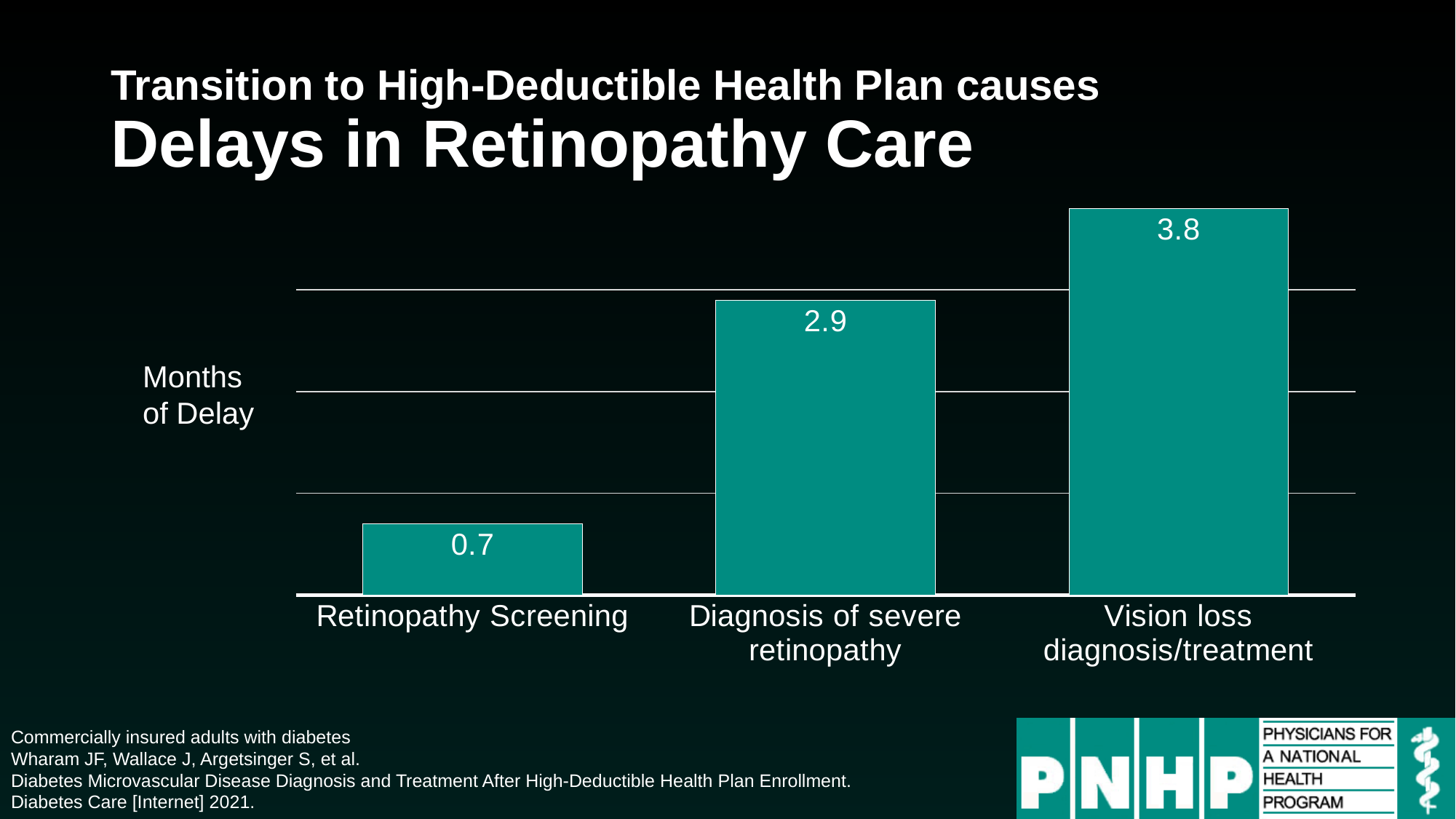
What is the months of delay for Retinopathy Screening? 0.7 What is the label on the vertical axis of the chart? Months of Delay What kind of chart is shown on the slide? Bar chart What is the months of delay for Diagnosis of severe retinopathy? 2.9 How many categories are shown in the chart? 3 Which category has the lowest months of delay? Retinopathy Screening Do the values rise or fall from left to right across the categories? Rise What is the difference in months of delay between Diagnosis of severe retinopathy and Retinopathy Screening? 2.2 Which category has the highest months of delay? Vision loss diagnosis/treatment Which has a larger months of delay, Diagnosis of severe retinopathy or Vision loss diagnosis/treatment? Vision loss diagnosis/treatment What is the months of delay for Vision loss diagnosis/treatment? 3.8 What is the difference in months of delay between Vision loss diagnosis/treatment and Retinopathy Screening? 3.1